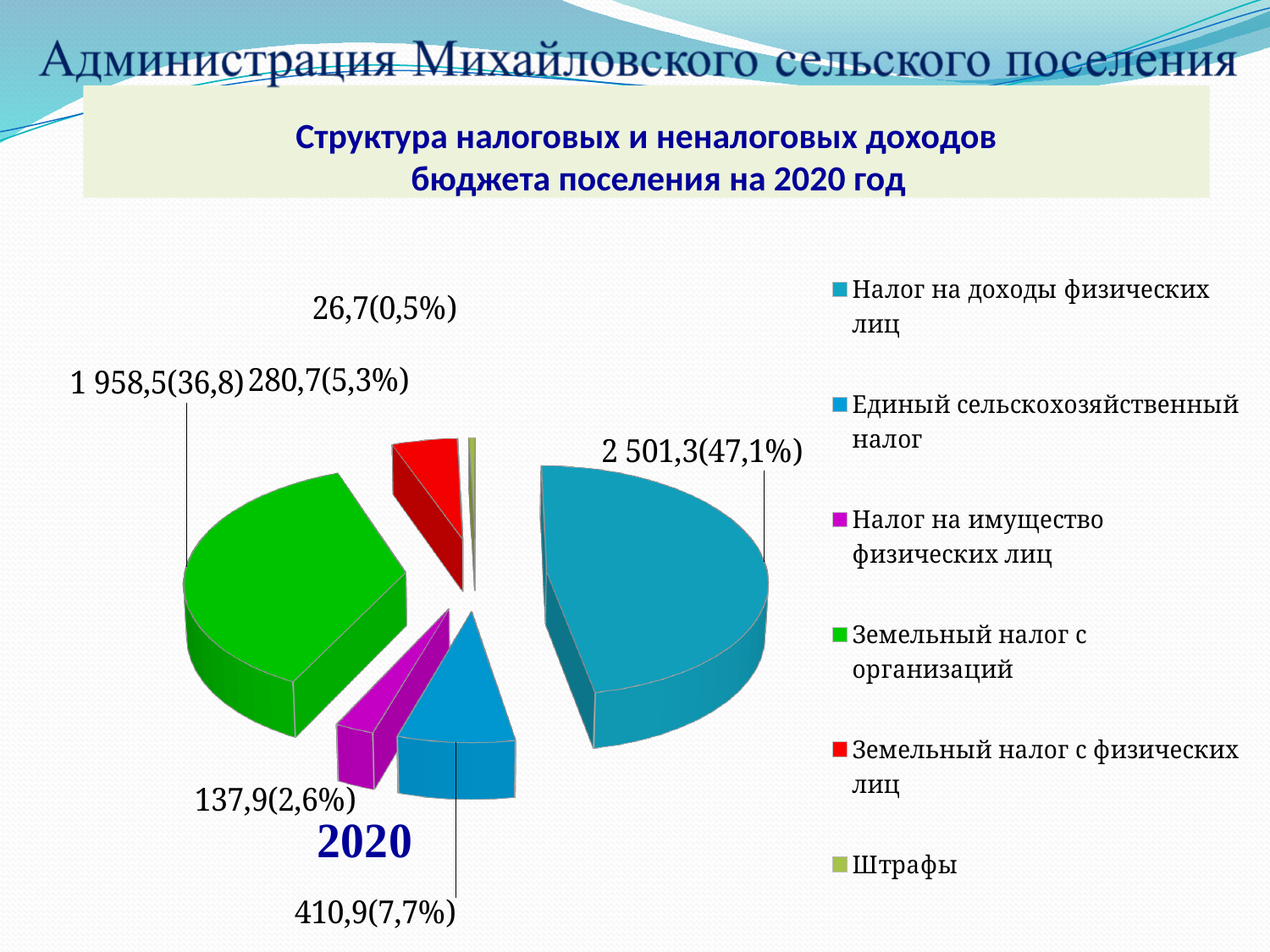
Which category has the largest slice of the pie? Налог на доходы физических лиц How many series does the legend list? 6 What value is shown for Единый сельскохозяйственный налог? 410,9(7,7%) What value is shown for Земельный налог с организаций? 1 958,5(36,8) What value is shown for Штрафы? 26,7(0,5%) What value is shown for Налог на доходы физических лиц? 2 501,3(47,1%) What kind of chart is shown on the slide? pie chart What is the title printed on the chart itself? 2020 Which is larger, Единый сельскохозяйственный налог or Налог на имущество физических лиц? Единый сельскохозяйственный налог Which category has the smallest slice of the pie? Штрафы What share of the pie does Налог на имущество физических лиц have? 2,6% What share of the pie does Земельный налог с физических лиц have? 5,3%